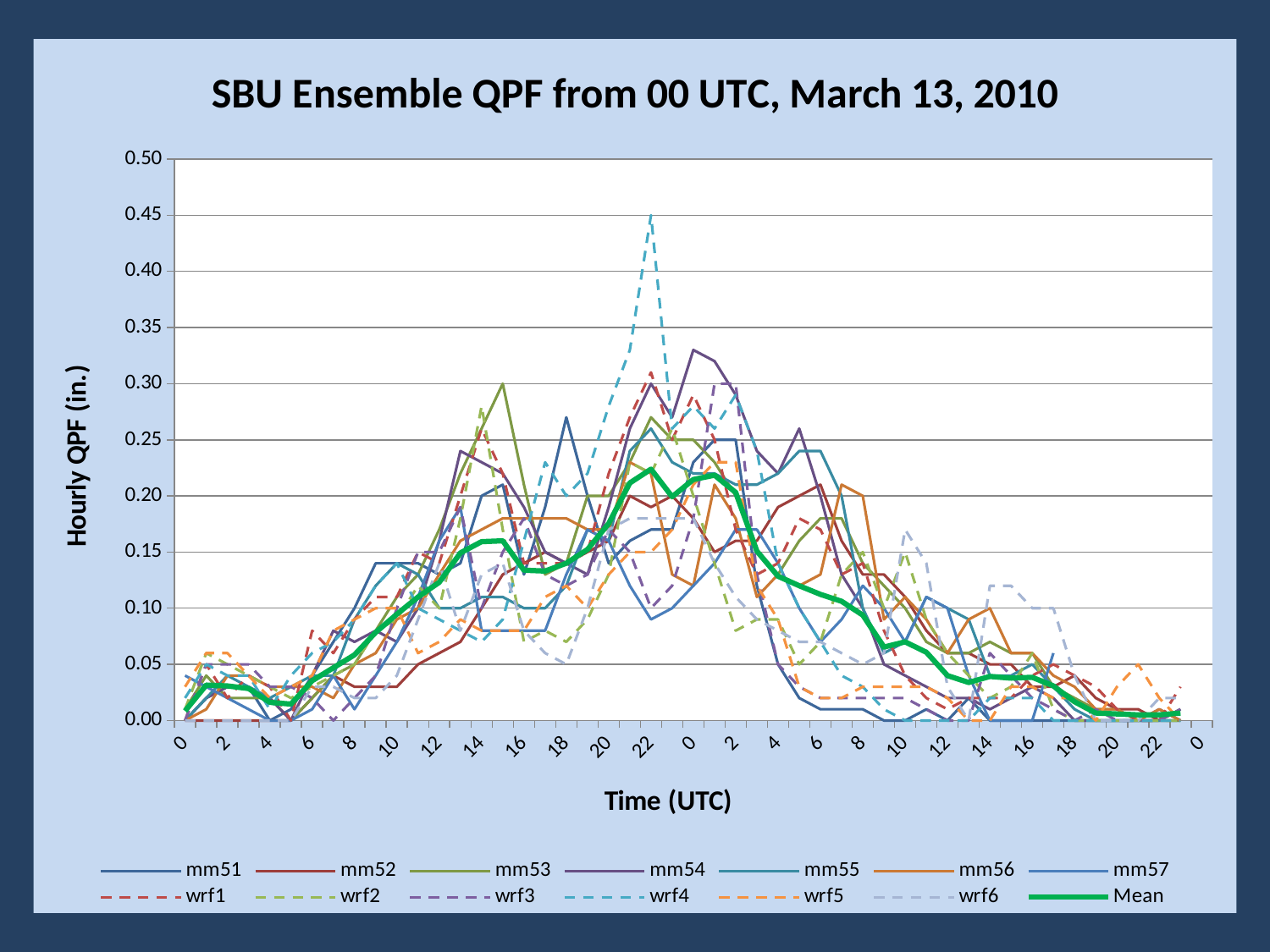
What is the highest value shown on the vertical axis? 0.50 Does the Mean series rise or fall between 22 UTC on the first day and the end of the x axis? fall Is the peak value of the Mean series greater or less than 0.25? less How many series does the legend list? 14 Is the peak value of the wrf4 series greater or less than 0.40? greater Is the value of the Mean series at the first time point (0 UTC) greater or less than 0.05? less Which has a higher peak value, the wrf4 series or the Mean series? wrf4 What is the label of the vertical axis? Hourly QPF (in.) What kind of chart is shown on the slide? Line chart What is the title of the chart? SBU Ensemble QPF from 00 UTC, March 13, 2010 Which series reaches the highest peak value on the chart? wrf4